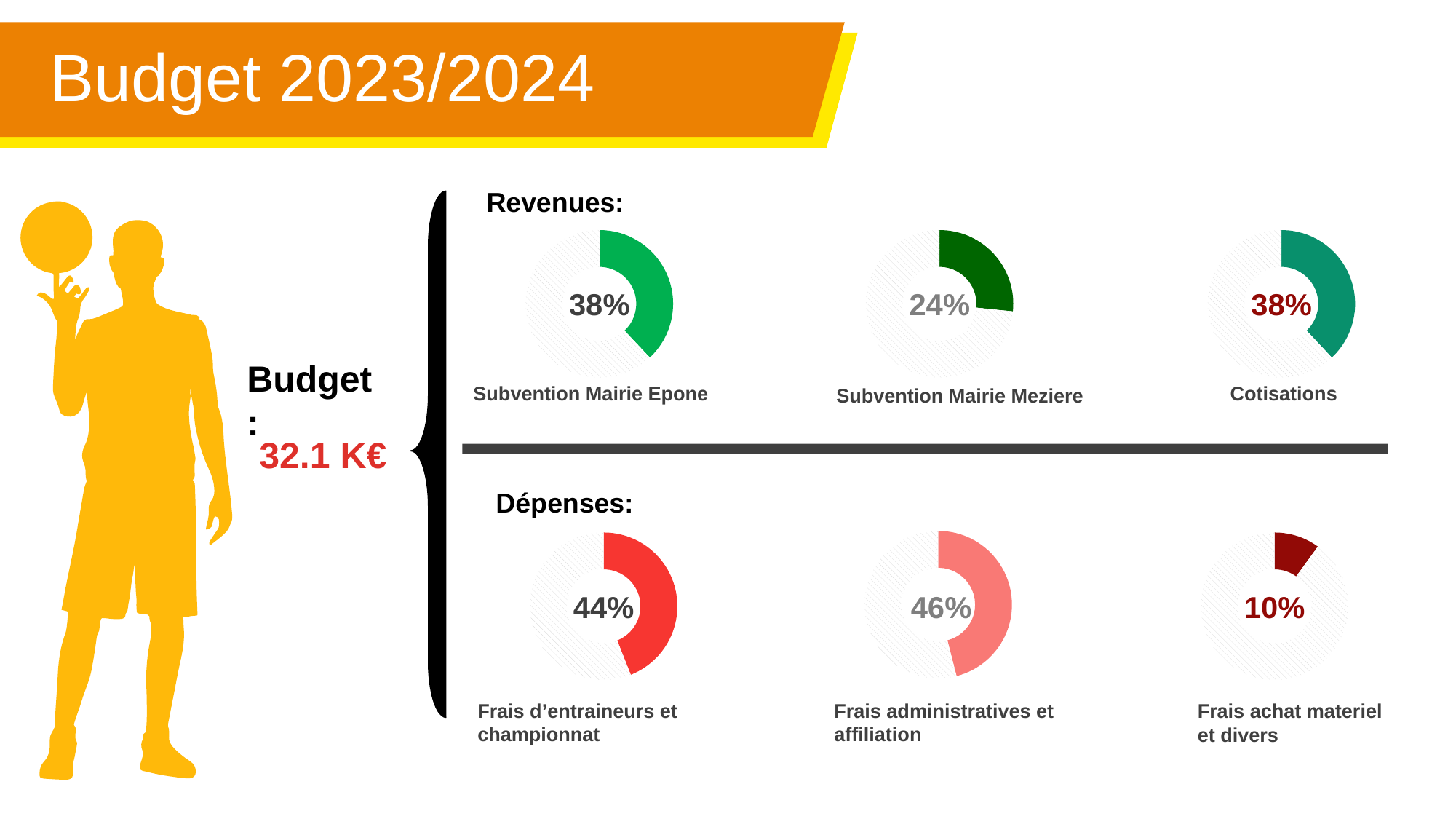
In the Dépenses section, what percentage is shown for Frais d'entraineurs et championnat? 44% In the Dépenses section, what percentage is shown for Frais achat materiel et divers? 10% In the Dépenses section, which category has the lowest percentage? Frais achat materiel et divers In the Revenues section, what percentage is shown for Cotisations? 38% What kind of chart is used to show each percentage on the slide? Donut chart In the Revenues section, which category has the lowest percentage? Subvention Mairie Meziere In the Dépenses section, what percentage is shown for Frais administratives et affiliation? 46% In the Revenues section, what percentage is shown for Subvention Mairie Meziere? 24% In the Revenues section, what percentage is shown for Subvention Mairie Epone? 38% How many ring charts are shown in the Dépenses section? 3 In the Dépenses section, which category has the highest percentage? Frais administratives et affiliation In the Dépenses section, what is the difference between the percentages for Frais administratives et affiliation and Frais d'entraineurs et championnat? 2%